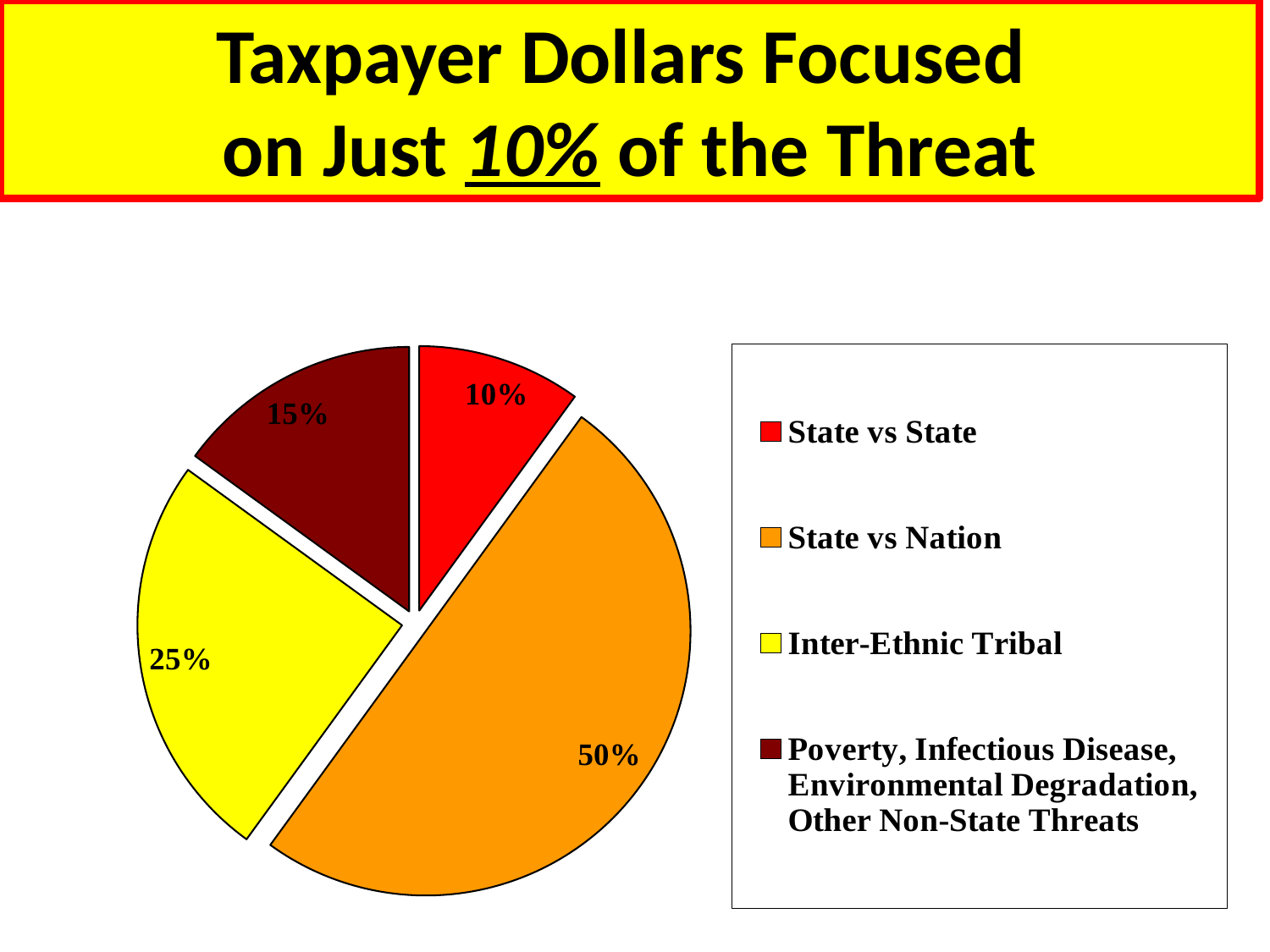
How many categories does the pie chart have? 4 What kind of chart is shown on the slide? pie chart Which category has the smallest slice of the pie? State vs State What colour is the State vs Nation slice? orange Which category has the largest slice of the pie? State vs Nation What share of the pie does State vs Nation represent? 50% What is the value shown for Poverty, Infectious Disease, Environmental Degradation, Other Non-State Threats? 15% Which is larger, the Inter-Ethnic Tribal slice or the Poverty, Infectious Disease, Environmental Degradation, Other Non-State Threats slice? Inter-Ethnic Tribal What is the value shown for Inter-Ethnic Tribal? 25% What is the difference between the State vs Nation slice and the Inter-Ethnic Tribal slice? 25% What is the value shown for State vs State? 10% What is the title of the slide? Taxpayer Dollars Focused on Just 10% of the Threat